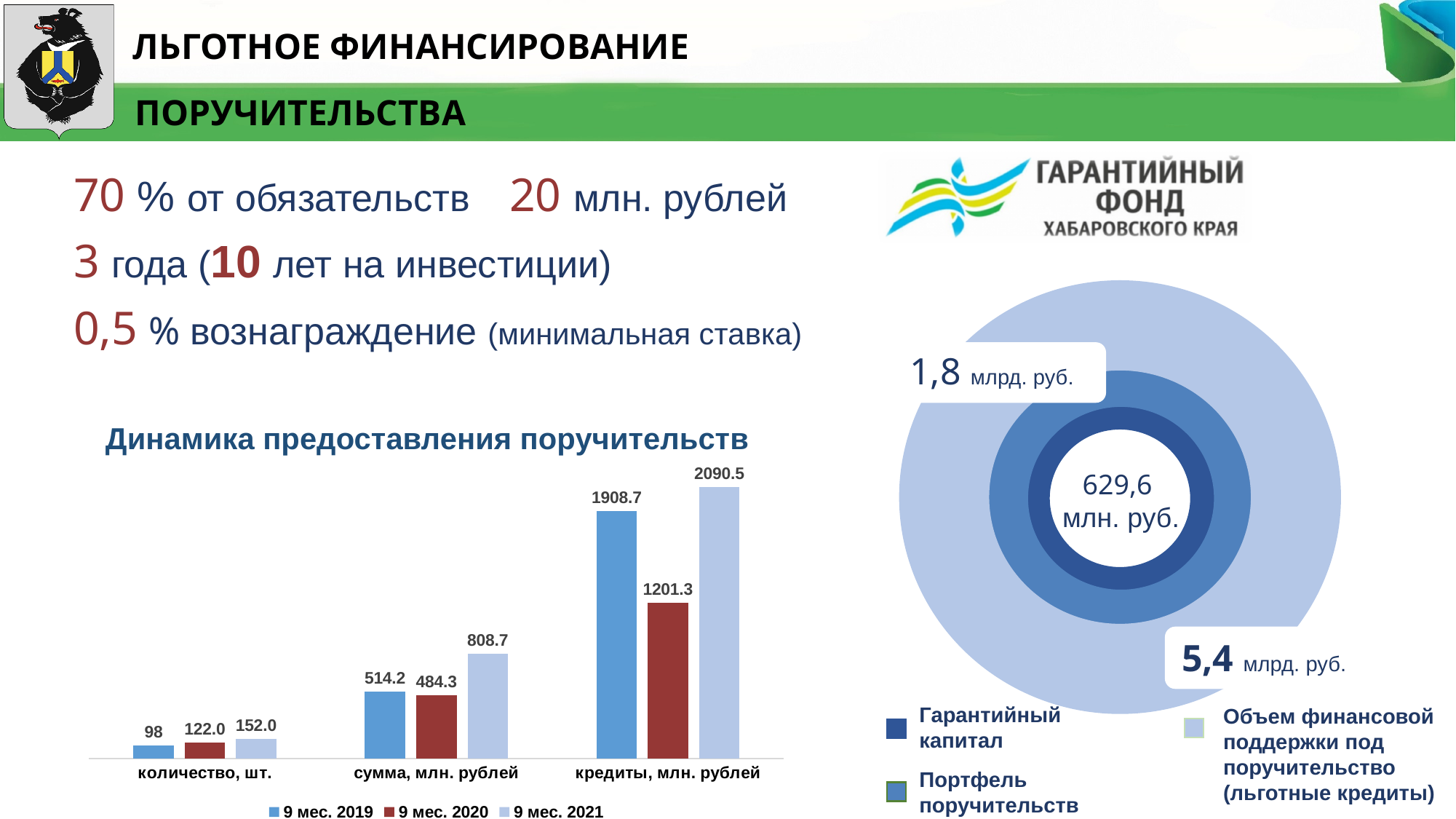
In the chart 'Динамика предоставления поручительств', what is the difference between the '9 мес. 2021' and '9 мес. 2019' values for 'сумма, млн. рублей'? 294.5 In the chart 'Динамика предоставления поручительств', which series has the lowest value for 'сумма, млн. рублей'? 9 мес. 2020 In the chart 'Динамика предоставления поручительств', which is larger for 'кредиты, млн. рублей': the '9 мес. 2020' value or the '9 мес. 2019' value? 9 мес. 2019 In the chart 'Динамика предоставления поручительств', what is the value for 'кредиты, млн. рублей' in the series '9 мес. 2021'? 2090.5 How many categories are shown on the x axis of the chart 'Динамика предоставления поручительств'? 3 What kind of chart is 'Динамика предоставления поручительств'? bar chart How many series does the legend of the chart 'Динамика предоставления поручительств' list? 3 In the chart 'Динамика предоставления поручительств', what is the difference between the '9 мес. 2021' and '9 мес. 2019' values for 'кредиты, млн. рублей'? 181.8 In the chart 'Динамика предоставления поручительств', which series has the highest value for 'кредиты, млн. рублей'? 9 мес. 2021 In the ring chart on the right of the slide, what value is shown for 'Гарантийный капитал' in the centre? 629,6 млн. руб. In the chart 'Динамика предоставления поручительств', what is the value for 'количество, шт.' in the series '9 мес. 2019'? 98 In the chart 'Динамика предоставления поручительств', what is the value for 'сумма, млн. рублей' in the series '9 мес. 2020'? 484.3